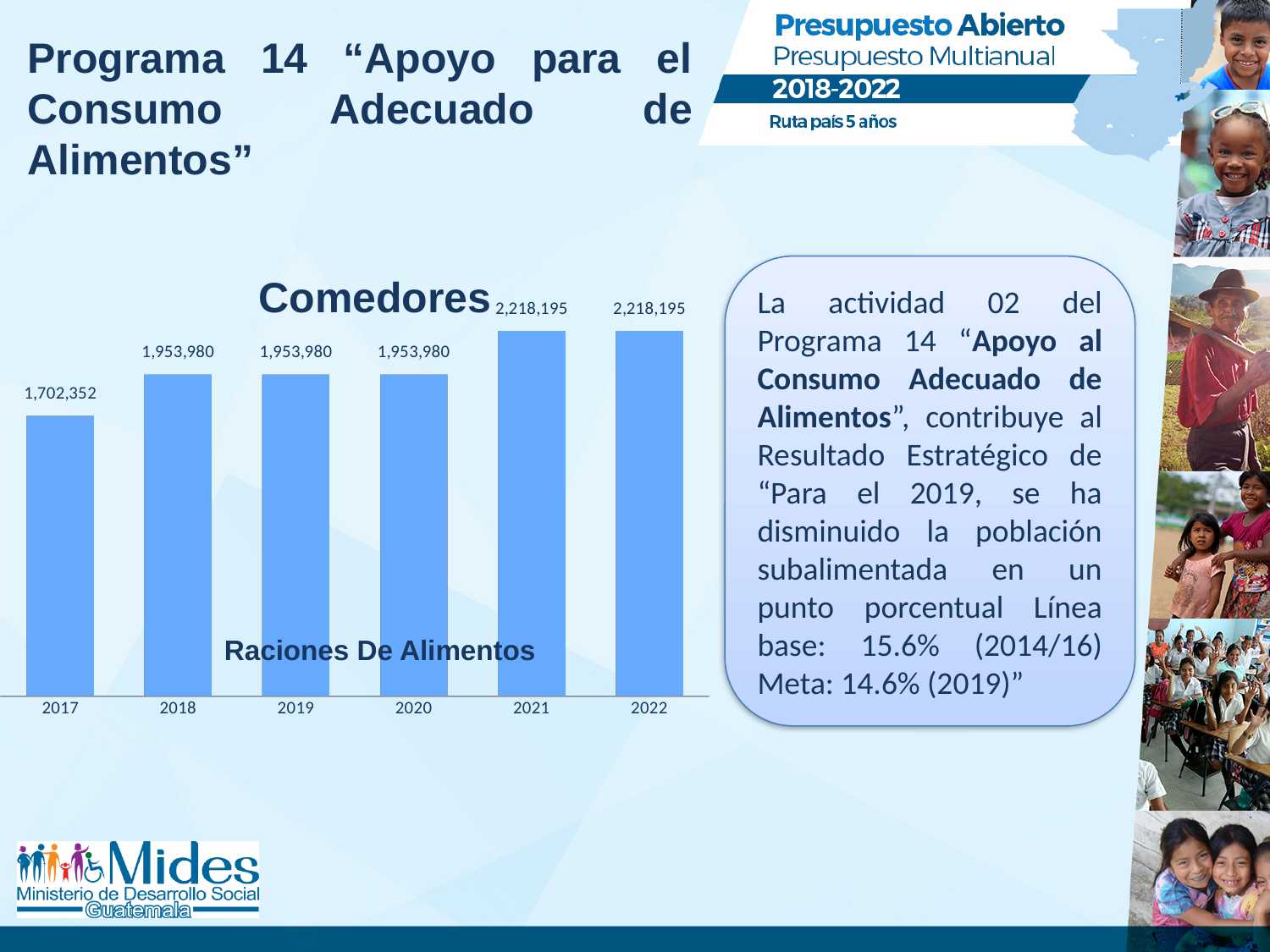
Do the values in the Comedores chart generally rise or fall from 2017 to 2022? rise How many years are shown on the x axis of the Comedores chart? 6 Which is larger in the Comedores chart, the value for 2020 or the value for 2021? 2021 What is the difference between the 2021 and 2020 values in the Comedores chart? 264,215 What is the difference between the 2018 and 2017 values in the Comedores chart? 251,628 What kind of chart is the Comedores chart? bar chart What is the difference between the 2022 and 2017 values in the Comedores chart? 515,843 What is the value for 2019 in the Comedores chart? 1,953,980 What is the value for 2017 in the Comedores chart? 1,702,352 Which year has the lowest value in the Comedores chart? 2017 What is the value for 2022 in the Comedores chart? 2,218,195 What is the value for 2021 in the Comedores chart? 2,218,195